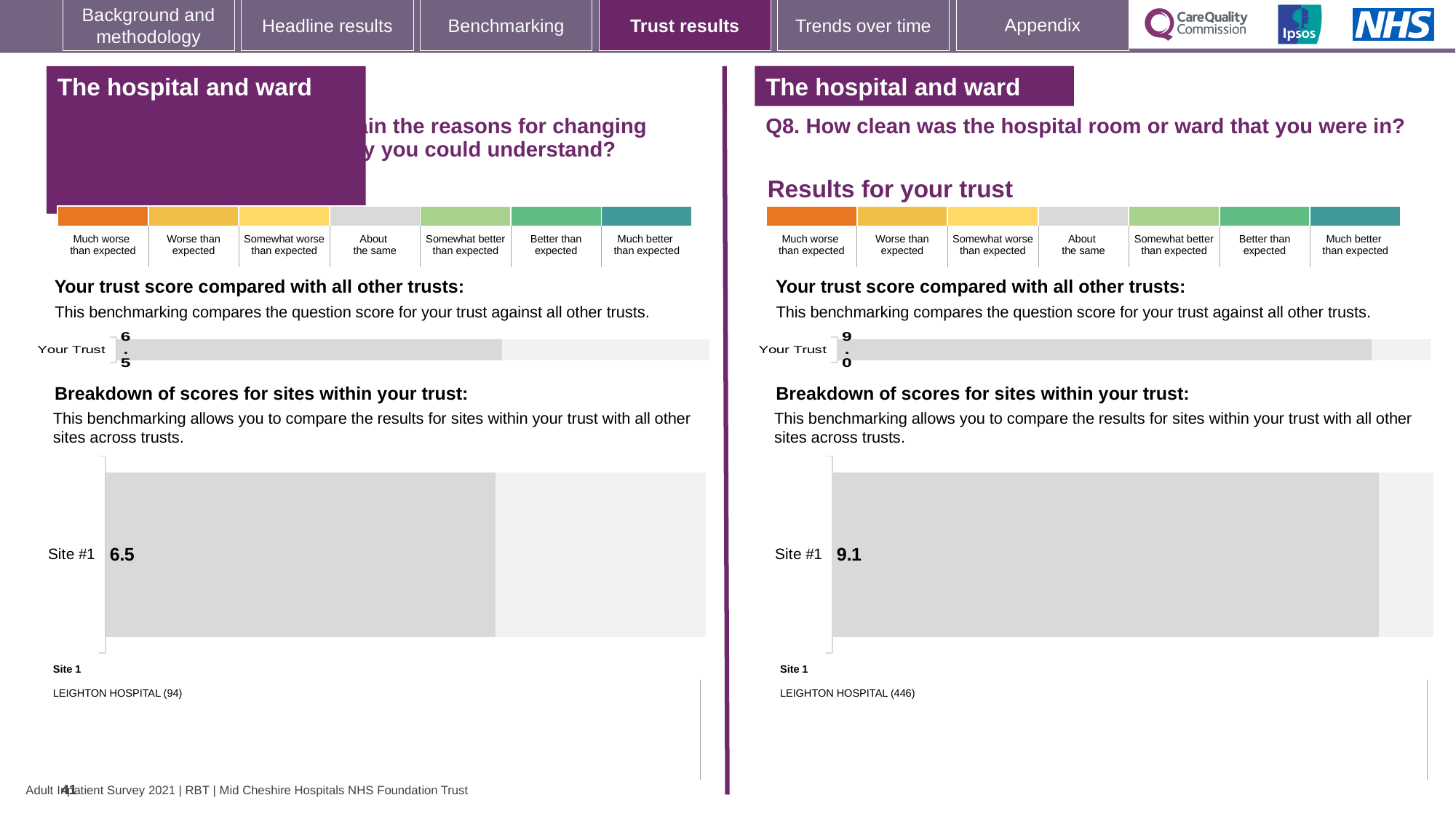
On the right-hand side of the slide, which hospital is listed as Site 1 and how many respondents are shown in brackets? LEIGHTON HOSPITAL (446) What is the difference between the Your Trust score on the right-hand Q8 chart and the Your Trust score on the left-hand chart? 2.5 How many sites are shown in the site breakdown chart on the right-hand side of the slide? 1 On the left-hand site breakdown chart, what is the score shown for Site #1? 6.5 What is the difference between the Site #1 score on the right-hand Q8 chart and the Site #1 score on the left-hand chart? 2.6 On the right-hand Q8 chart, is the Site #1 score greater or less than the Your Trust score? greater Which is larger: the Site #1 score on the left-hand chart or the Site #1 score on the right-hand Q8 chart? Right-hand Q8 chart (9.1) On the right-hand chart for Q8 (how clean was the hospital room or ward), what is the score shown for Your Trust? 9.0 On the left-hand side of the slide, how many respondents are shown in brackets for LEIGHTON HOSPITAL under Site 1? 94 What type of chart is used to show the Site #1 score on the right-hand side of the slide? Bar chart On the right-hand site breakdown chart for Q8, what is the score shown for Site #1? 9.1 On the left-hand chart, what is the score shown for Your Trust? 6.5